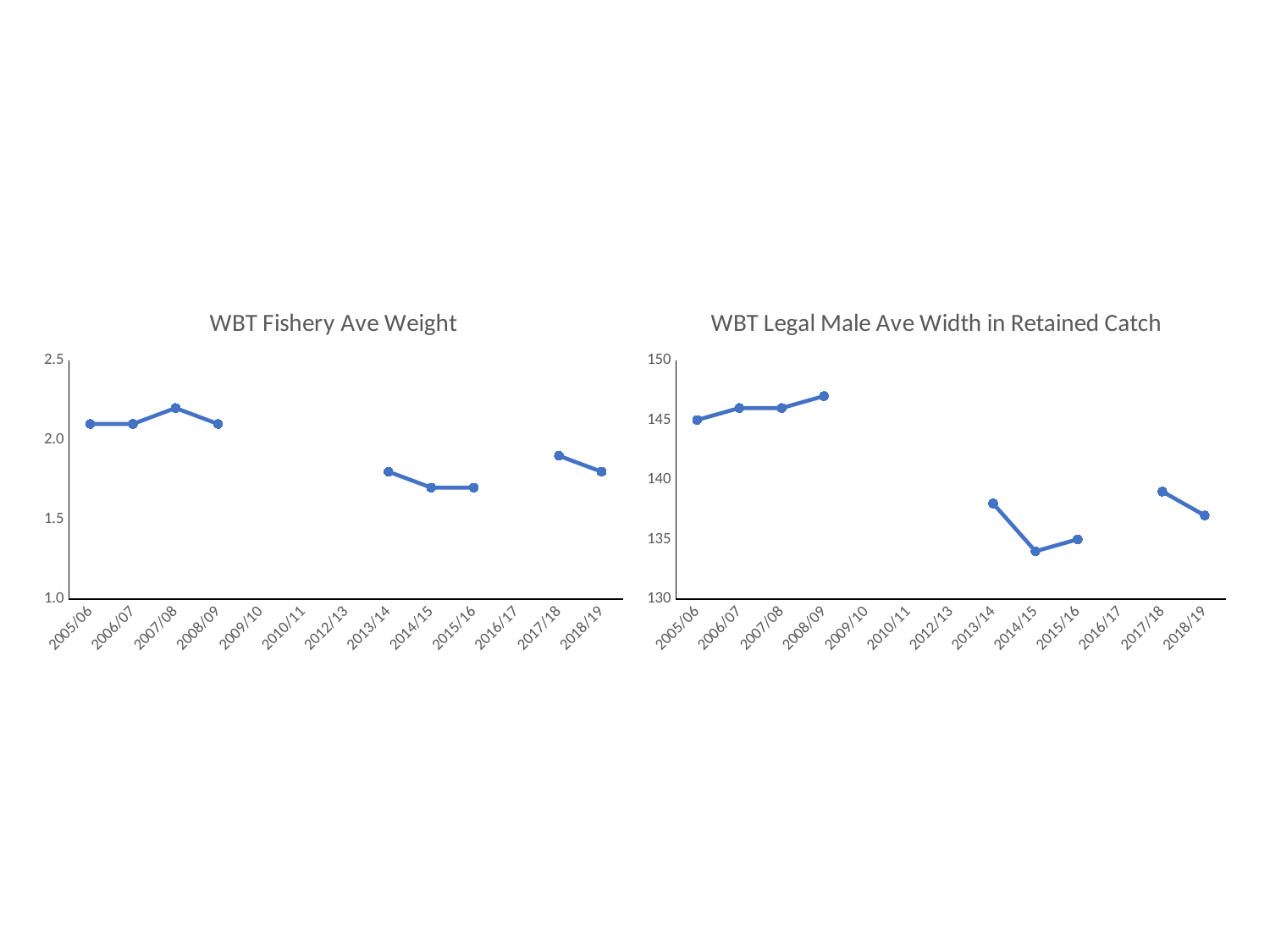
In the 'WBT Legal Male Ave Width in Retained Catch' chart, which season has the lowest value? 2014/15 In the 'WBT Legal Male Ave Width in Retained Catch' chart, is the value for 2008/09 greater or less than 145? greater In the 'WBT Fishery Ave Weight' chart, is the value for 2014/15 greater or less than 2.0? less What is the title of the chart on the right side of the slide? WBT Legal Male Ave Width in Retained Catch In the 'WBT Legal Male Ave Width in Retained Catch' chart, is the value for 2017/18 greater or less than 140? less In the 'WBT Fishery Ave Weight' chart, which is larger, the value for 2005/06 or the value for 2014/15? 2005/06 In the 'WBT Fishery Ave Weight' chart, which season has the highest value? 2007/08 In the 'WBT Legal Male Ave Width in Retained Catch' chart, do the values rise or fall from 2005/06 to 2008/09? rise What kind of chart is the 'WBT Fishery Ave Weight' chart? line chart In the 'WBT Legal Male Ave Width in Retained Catch' chart, which season has the highest value? 2008/09 How many seasons are labelled on the x axis of the 'WBT Fishery Ave Weight' chart? 13